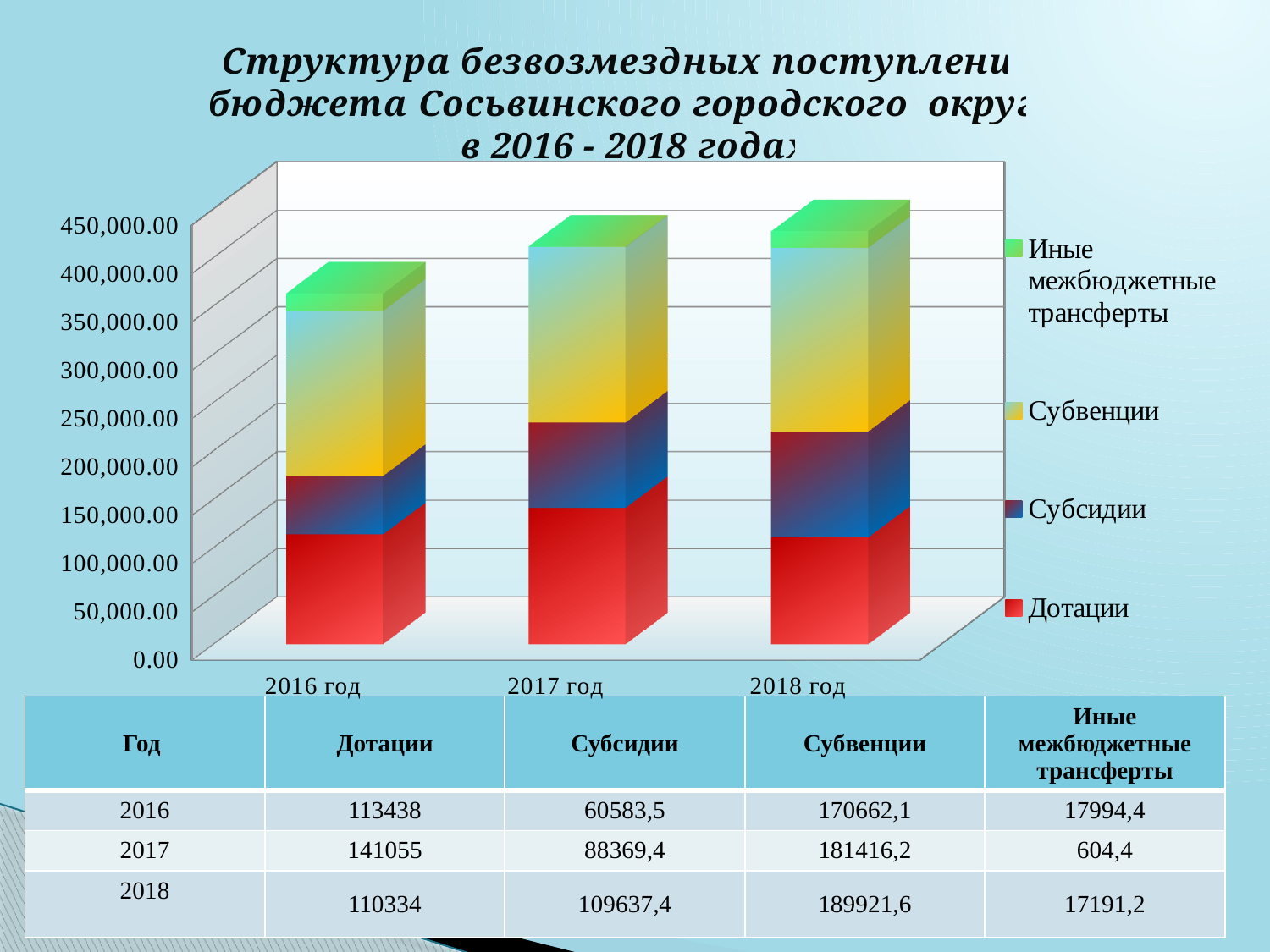
What is the value of Субвенции for 2018? 189921,6 Which colour represents Дотации in the chart? Red Is the total height of the 2016 stacked bar greater or less than 400,000.00? less How many years (categories) are plotted on the x axis? 3 What is the total of the stacked bar for 2017? 411445 What is the value of Субсидии for 2016? 60583,5 What is the difference between Дотации in 2017 and Дотации in 2016? 27617 In which year is the value of Дотации the highest? 2017 What kind of chart is shown on the slide? Stacked bar chart How many series does the chart legend list? 4 Which is larger: Субсидии in 2018 or Субсидии in 2017? Субсидии in 2018 In which year is the value of Иные межбюджетные трансферты the lowest? 2017